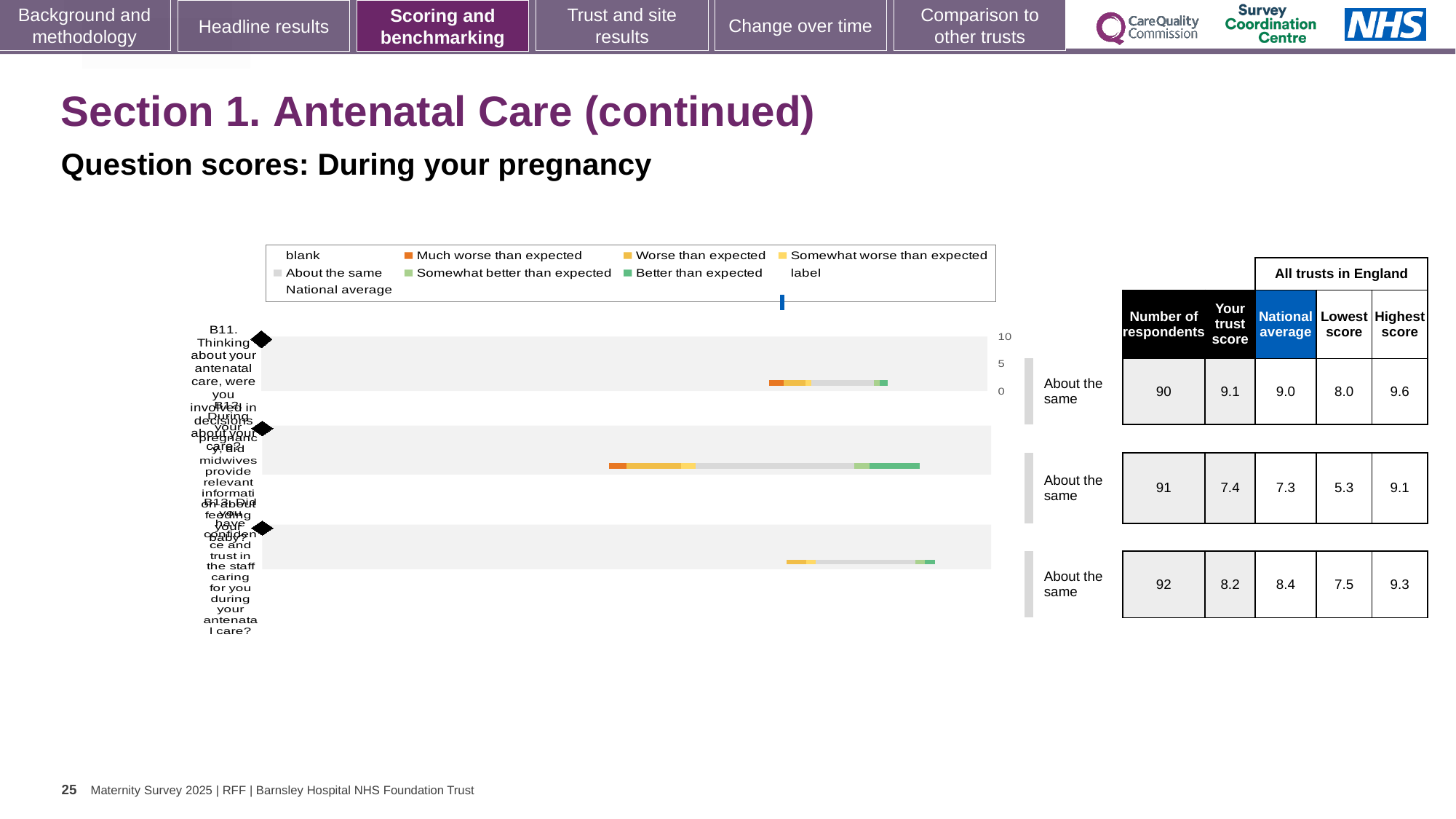
What is the difference between the highest score and the lowest score for question B11? 1.6 Which question (B11, B12 or B13) has the lowest trust score in the table? B12 What is the national average for question B12 in the table next to the chart? 7.3 What is the lowest score across all trusts in England for question B12? 5.3 How many question bars (categories) are plotted in the chart? 3 Is the trust score for question B13 larger or smaller than its national average? smaller How many entries does the chart legend list? 9 What benchmark label is shown beside each of the three bars? About the same Which question (B11, B12 or B13) has the highest trust score in the table? B11 What is the trust score for question B11 in the table next to the chart? 9.1 What kind of chart is shown on the slide? bar chart What is the number of respondents for question B13 in the table next to the chart? 92